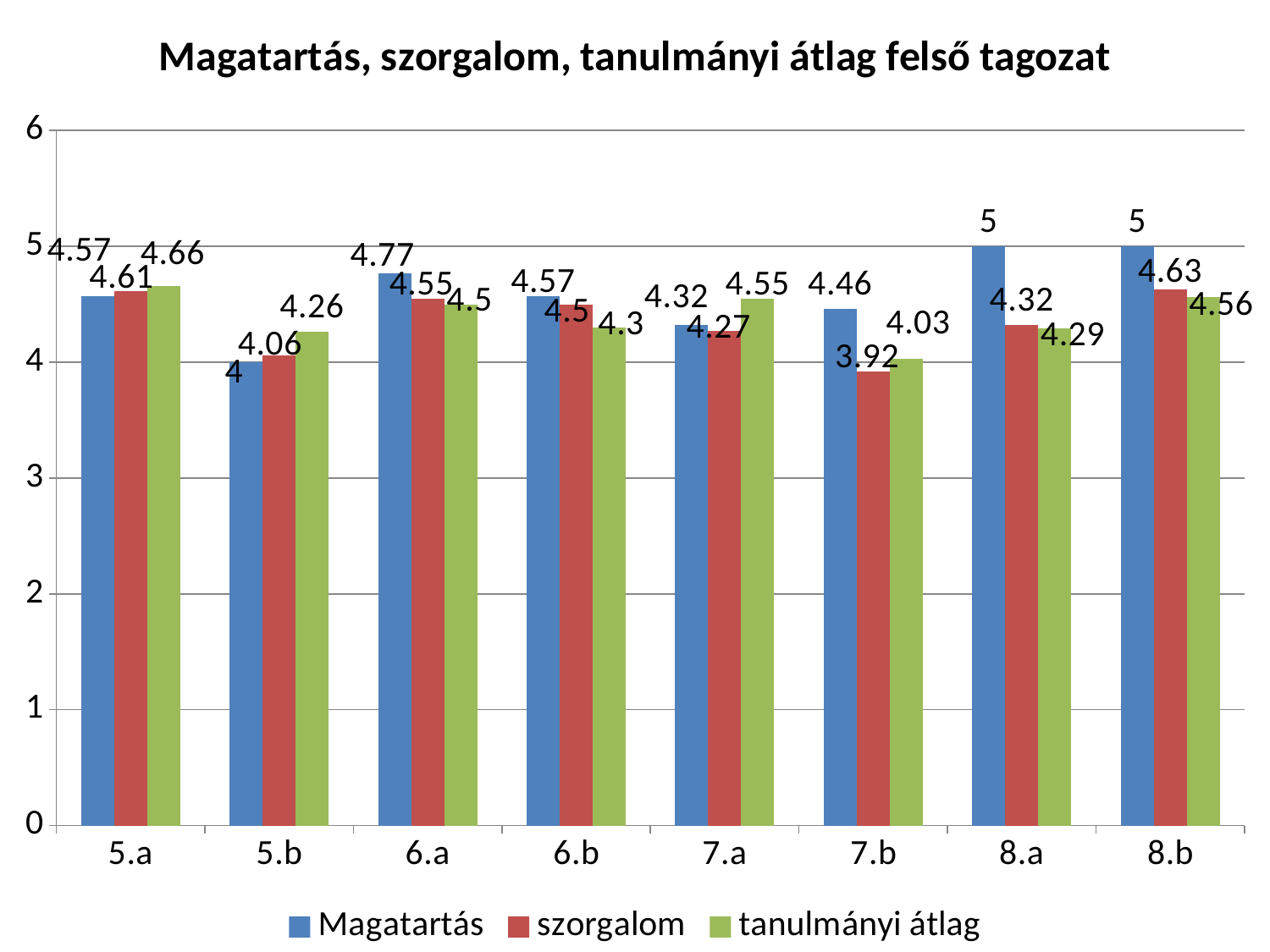
How many classes are shown on the x axis? 8 Which is larger for class 7.a: the Magatartás value or the tanulmányi átlag value? tanulmányi átlag What type of chart is shown on the slide? bar chart What is the tanulmányi átlag value for class 8.b? 4.56 What is the Magatartás value for class 6.a? 4.77 What is the difference between the Magatartás value for 8.a and the szorgalom value for 8.a? 0.68 Which class has the lowest Magatartás value? 5.b How many series does the legend list? 3 Which class has the lowest szorgalom value? 7.b Is the szorgalom value for class 7.b greater or less than 4? less What is the szorgalom value for class 7.b? 3.92 Which class has the highest tanulmányi átlag value? 5.a